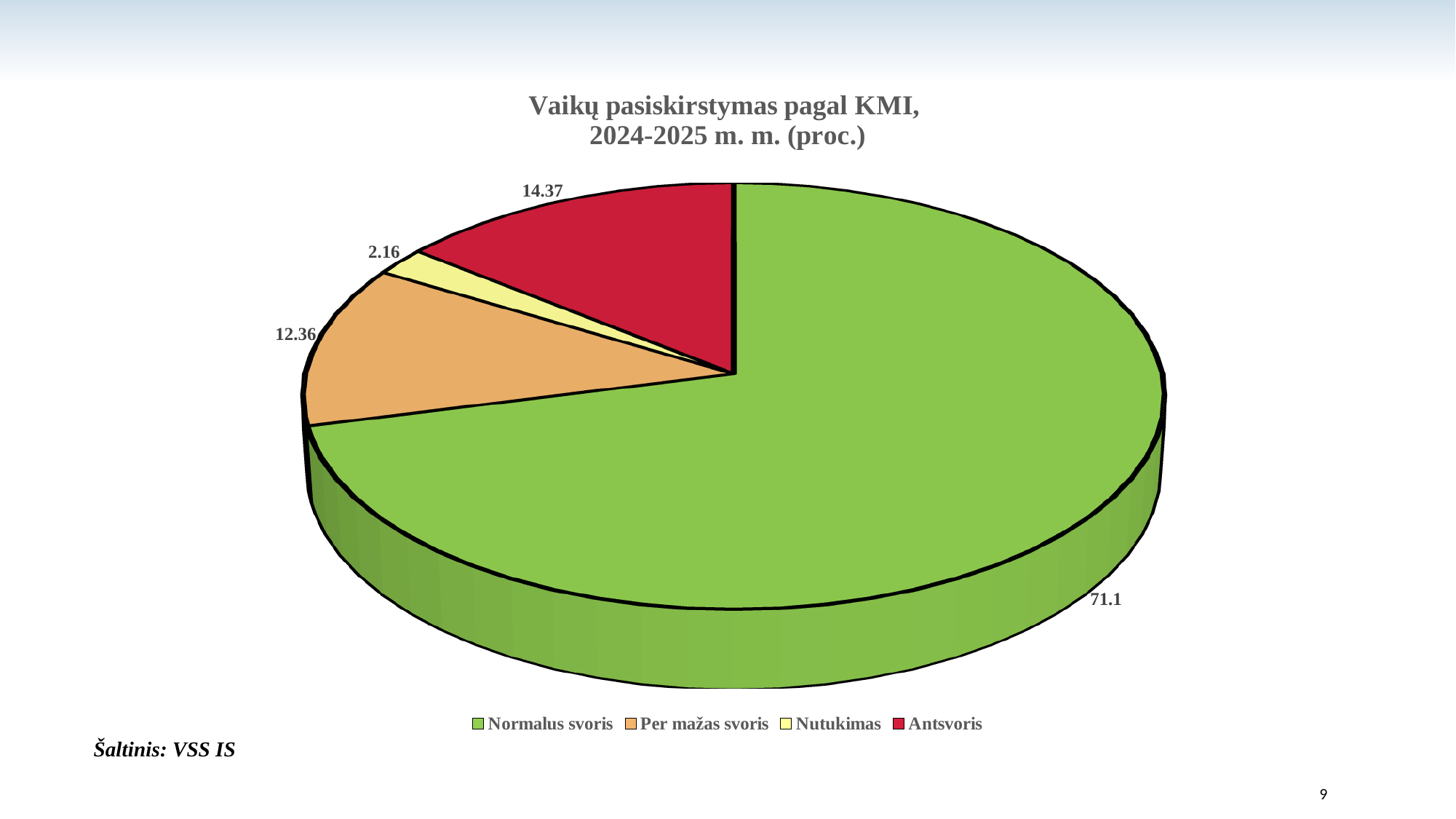
What is the value for Antsvoris? 14.37 Which category has the largest slice of the pie? Normalus svoris What is the title of the chart? Vaikų pasiskirstymas pagal KMI, 2024-2025 m. m. (proc.) What is the value for Nutukimas? 2.16 What is the value for Normalus svoris? 71.1 Which is larger, the value for Antsvoris or the value for Per mažas svoris? Antsvoris What is the value for Per mažas svoris? 12.36 What is the difference between the values for Antsvoris and Per mažas svoris? 2.01 Which category has the smallest slice of the pie? Nutukimas What kind of chart is shown on the slide? pie chart How many categories does the pie chart show? 4 Which colour represents Antsvoris in the legend? red